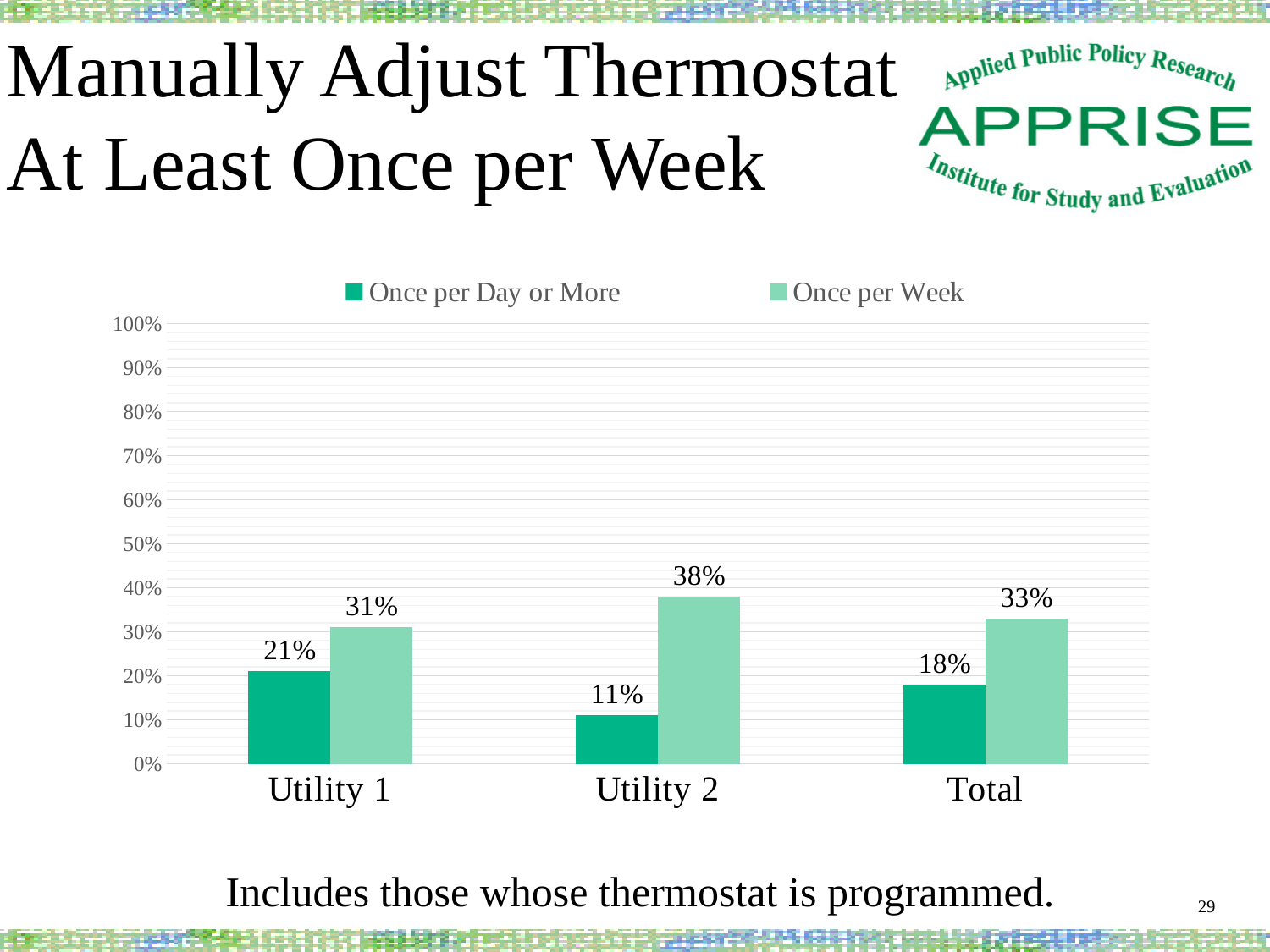
What kind of chart is shown on the slide? bar chart What is the value for Once per Day or More for Total? 18% What is the value for Once per Week for Utility 2? 38% What is the value for Once per Day or More for Utility 1? 21% How many categories are shown on the x axis? 3 What is the difference between the Once per Week and Once per Day or More values for Utility 2? 27% Is the Once per Week value for Utility 1 greater or less than 40%? less How many series does the legend list? 2 Which category has the lowest Once per Day or More value? Utility 2 What is the value for Once per Week for Total? 33% Which category has the highest Once per Week value? Utility 2 Which is larger for Utility 1: Once per Day or More or Once per Week? Once per Week